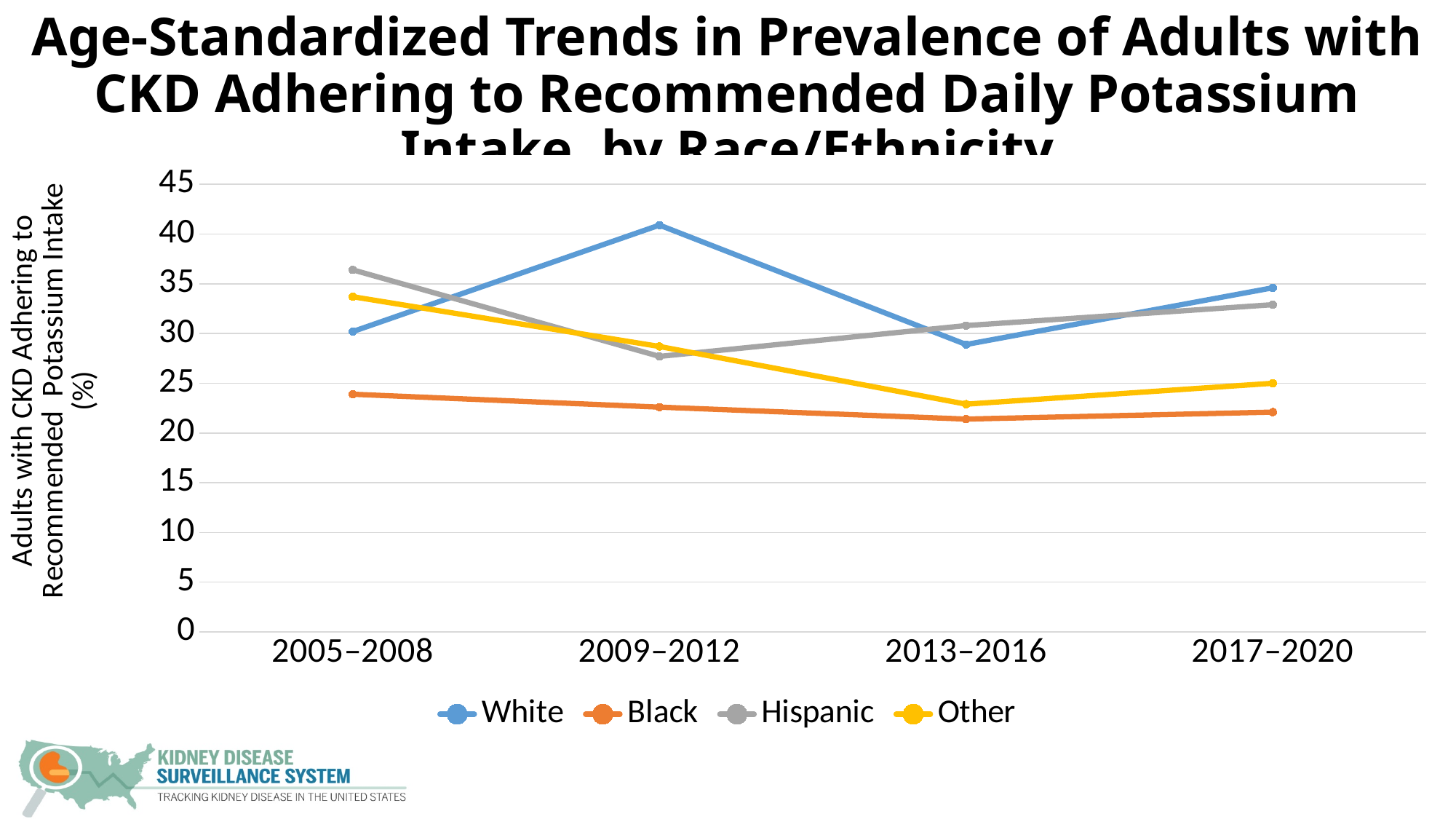
In 2017–2020, which is larger: the value for Other or the value for Black? Other Is the value for Black in 2013–2016 greater or less than 25? less Which series is drawn in yellow? Other How many time periods are shown on the x axis? 4 Is the value for Hispanic in 2005–2008 greater or less than 35? greater Is the value for White in 2009–2012 greater or less than 35? greater What kind of chart is shown on the slide? Line chart Which race/ethnicity group has the lowest value in 2005–2008? Black Does the Black series rise or fall from 2005–2008 to 2013–2016? Fall Which race/ethnicity group has the highest value in 2009–2012? White How many series does the legend list? 4 In 2005–2008, which is larger: the value for Hispanic or the value for White? Hispanic